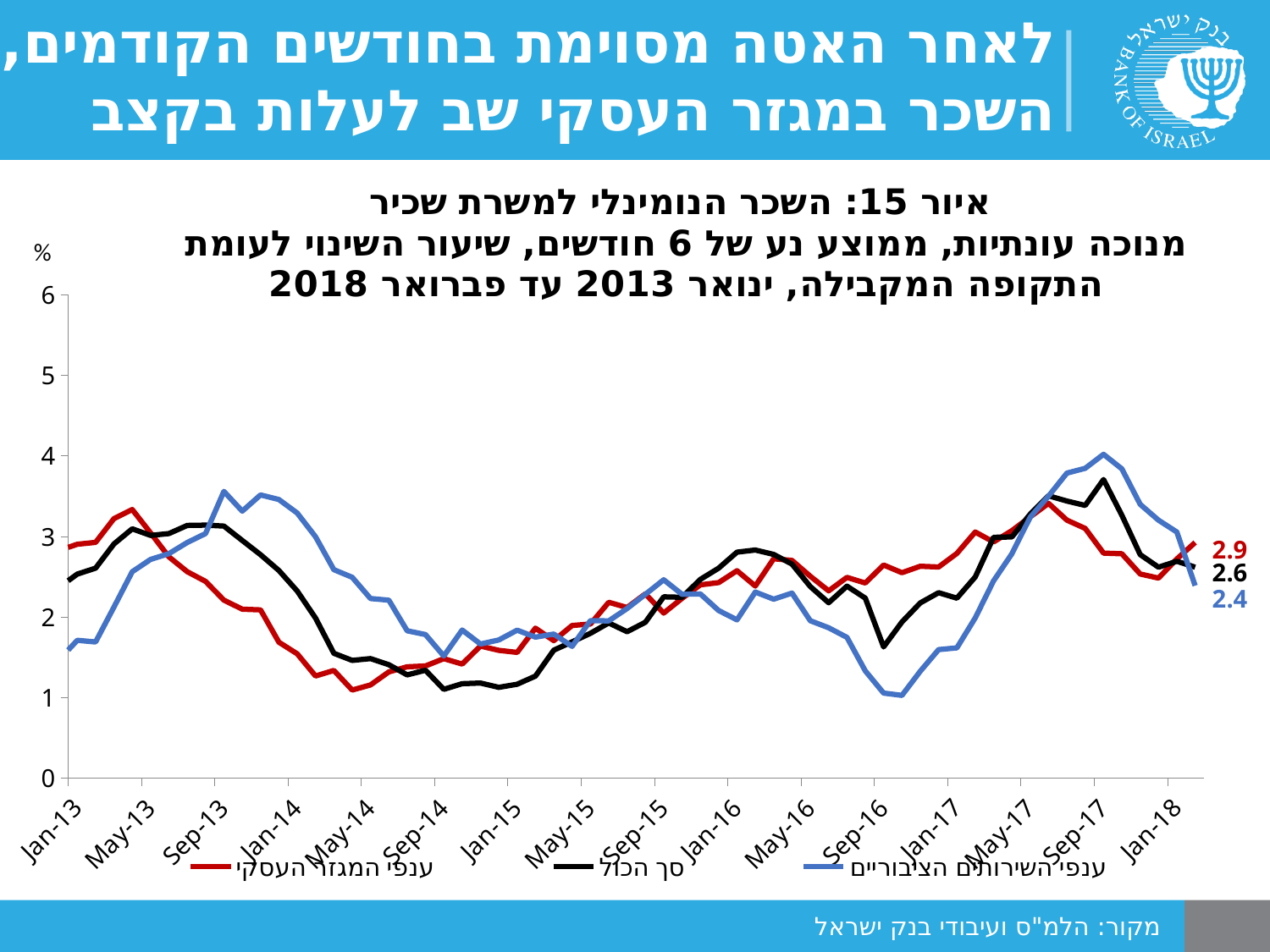
Which series has the highest final labelled value? ענפי המגזר העסקי Which series is drawn in red? ענפי המגזר העסקי What is the final labelled value of the סך הכול (black) series? 2.6 What is the final labelled value of the ענפי המגזר העסקי (red) series? 2.9 How many series does the legend list? 3 Is the value for ענפי השירותים הציבוריים at Sep-17 greater or less than 3? greater At the end of the series, which is higher: ענפי המגזר העסקי or ענפי השירותים הציבוריים? ענפי המגזר העסקי What kind of chart is shown on the slide? line chart Is the value for ענפי השירותים הציבוריים at Jan-13 greater or less than 2? less What is the difference between the final labelled values of ענפי המגזר העסקי and סך הכול? 0.3 What is the difference between the final labelled values of ענפי המגזר העסקי and ענפי השירותים הציבוריים? 0.5 What is the final labelled value of the ענפי השירותים הציבוריים (blue) series? 2.4